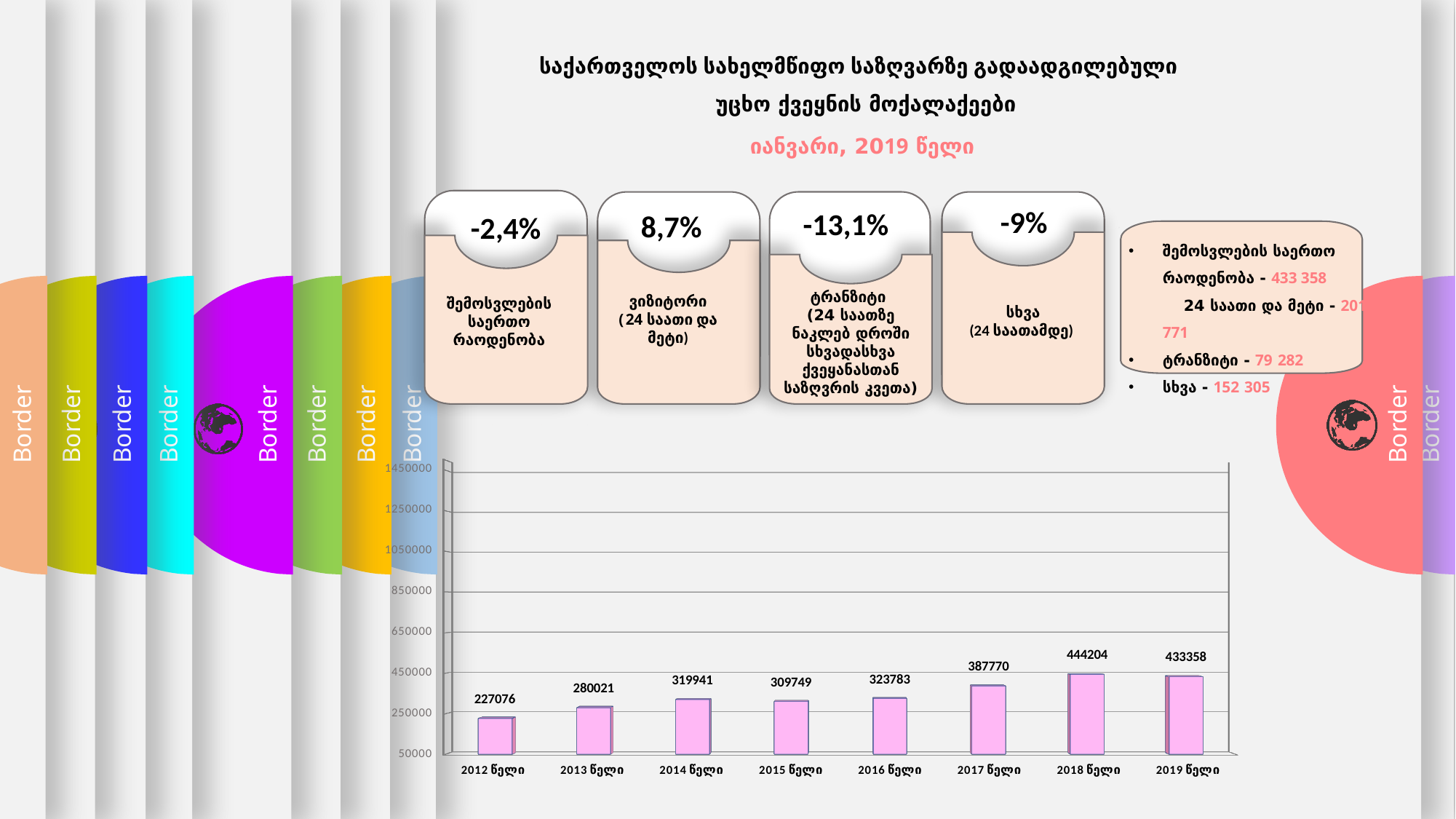
What is the difference between the values for 2018 and 2019 in the bar chart? 10846 How many years are shown in the bar chart? 8 Do the values in the bar chart generally rise or fall from 2012 to 2019? rise What kind of chart is shown on the slide? bar chart Which year has the highest value in the bar chart? 2018 Which is larger in the bar chart, the value for 2014 or the value for 2015? 2014 What is the value for 2016 in the bar chart? 323783 Which year has the lowest value in the bar chart? 2012 What is the difference between the values for 2013 and 2012 in the bar chart? 52945 Is the value for 2012 in the bar chart greater or less than 250000? less What is the value for 2012 in the bar chart? 227076 What is the value for 2019 in the bar chart? 433358